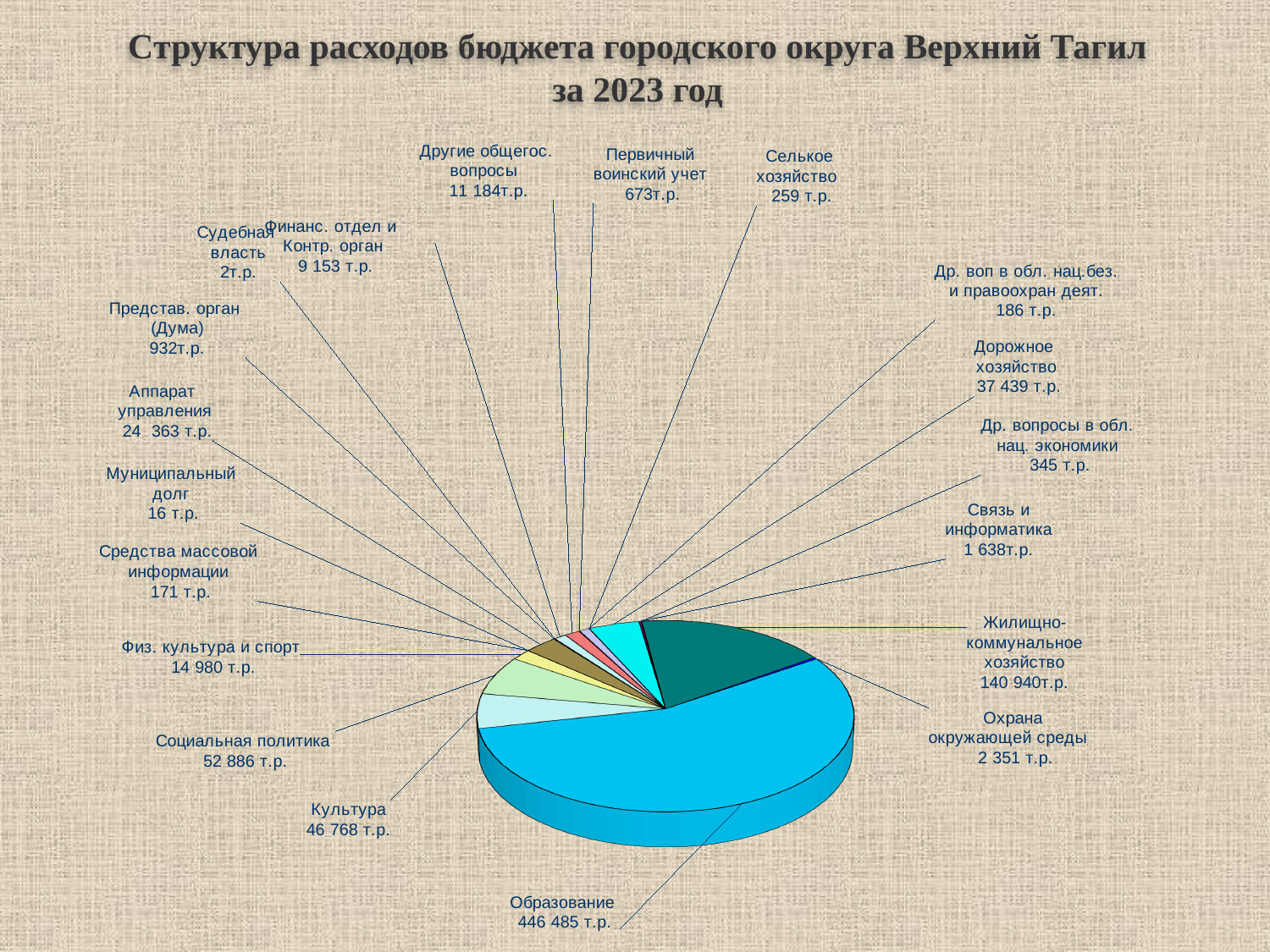
Which category has the smallest value? Судебная власть What is the value for Социальная политика? 52 886 т.р. What is the value for Судебная власть? 2т.р. How many categories are labelled on the pie chart? 19 Which is larger, Социальная политика or Культура? Социальная политика What is the value for Образование? 446 485 т.р. What is the difference between Социальная политика and Культура? 6 118 т.р. What is the title of the chart? Структура расходов бюджета городского округа Верхний Тагил за 2023 год What is the value for Жилищно-коммунальное хозяйство? 140 940т.р. Which category has the largest share of the pie? Образование What kind of chart is shown on the slide? pie chart What is the value for Дорожное хозяйство? 37 439 т.р.